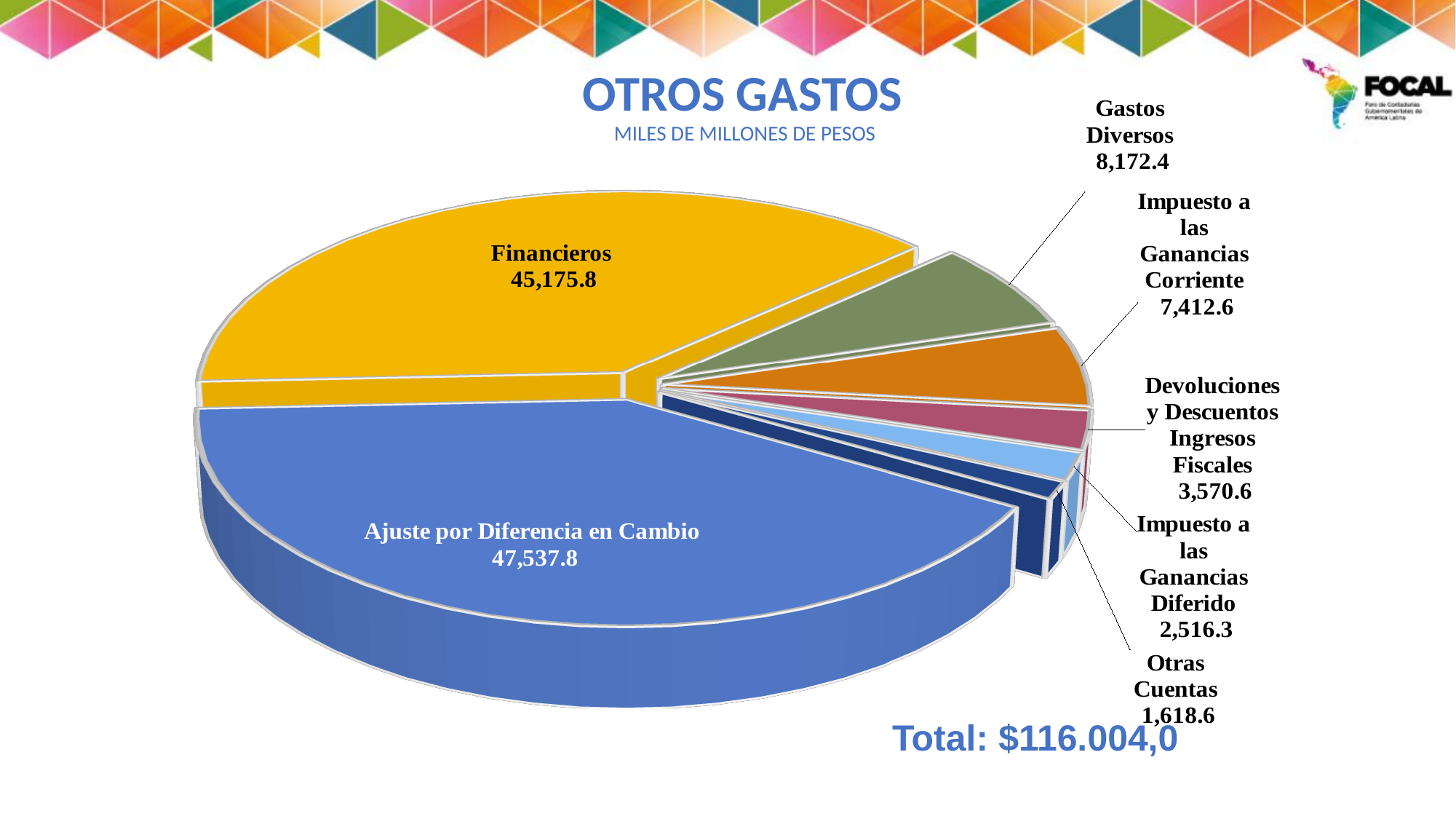
What is the value for Ajuste por Diferencia en Cambio? 47,537.8 Which is larger, Impuesto a las Ganancias Corriente or Devoluciones y Descuentos Ingresos Fiscales? Impuesto a las Ganancias Corriente How many slices does the pie chart have? 7 What kind of chart is shown on the slide? Pie chart What is the difference between Ajuste por Diferencia en Cambio and Financieros? 2,362.0 What is the value for Financieros? 45,175.8 What is the value for Otras Cuentas? 1,618.6 What total is printed on the slide for the chart? $116.004,0 Which category has the smallest slice? Otras Cuentas What is the value for Gastos Diversos? 8,172.4 Which category has the largest slice? Ajuste por Diferencia en Cambio What is the value for Impuesto a las Ganancias Diferido? 2,516.3